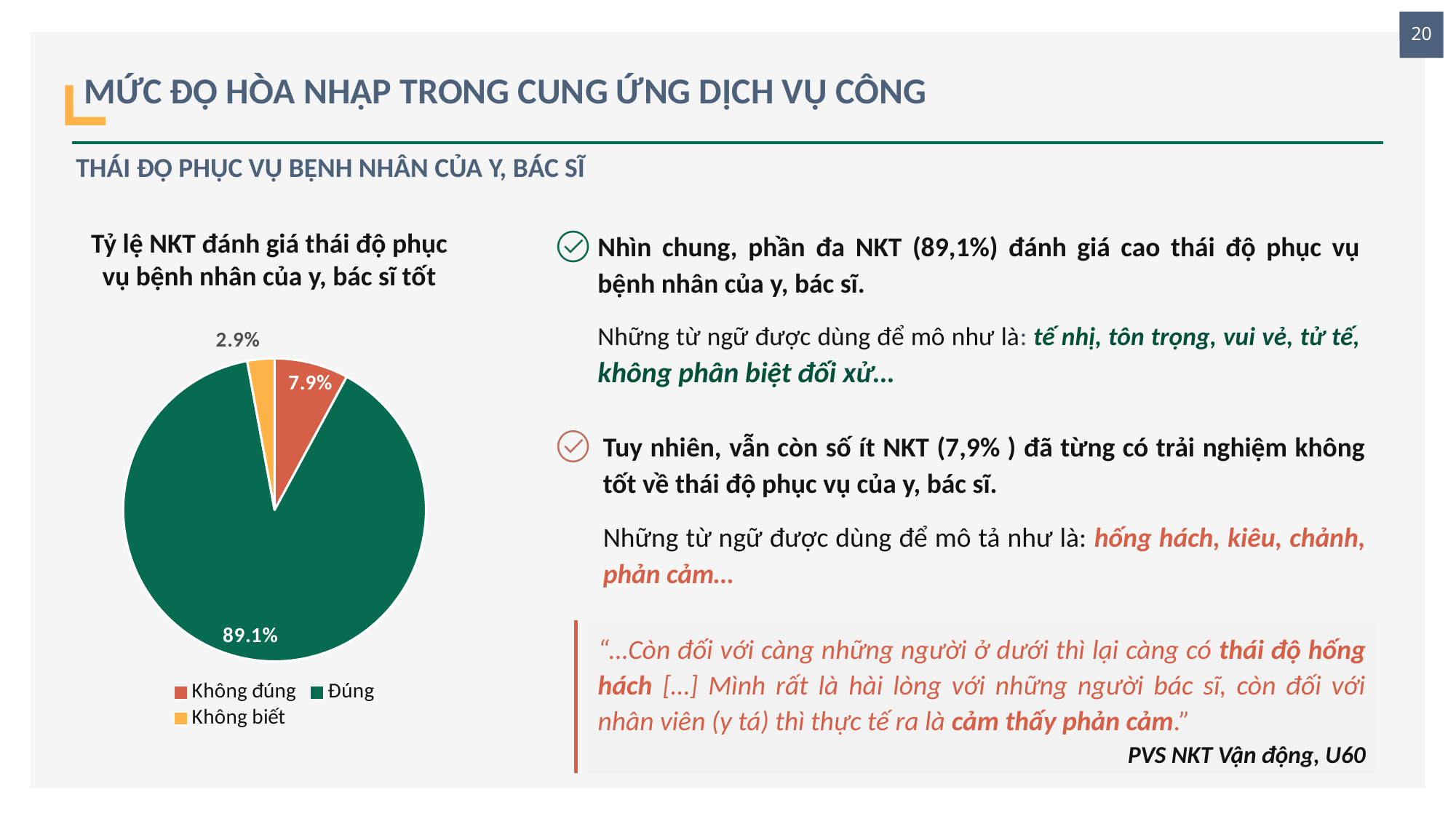
Which category has the largest slice in the pie chart? Đúng What type of chart is shown on the slide? pie chart What is the value for "Không đúng" in the pie chart? 7.9% What is the difference between the values for "Không đúng" and "Không biết"? 5.0% What colour is the "Đúng" slice in the pie chart? green How many categories does the pie chart show? 3 Which category has the smallest slice in the pie chart? Không biết Which is larger, the slice for "Không đúng" or the slice for "Không biết"? Không đúng What is the title of the pie chart? Tỷ lệ NKT đánh giá thái độ phục vụ bệnh nhân của y, bác sĩ tốt What is the value for "Không biết" in the pie chart? 2.9% What is the value for "Đúng" in the pie chart? 89.1% What is the difference between the values for "Đúng" and "Không đúng"? 81.2%